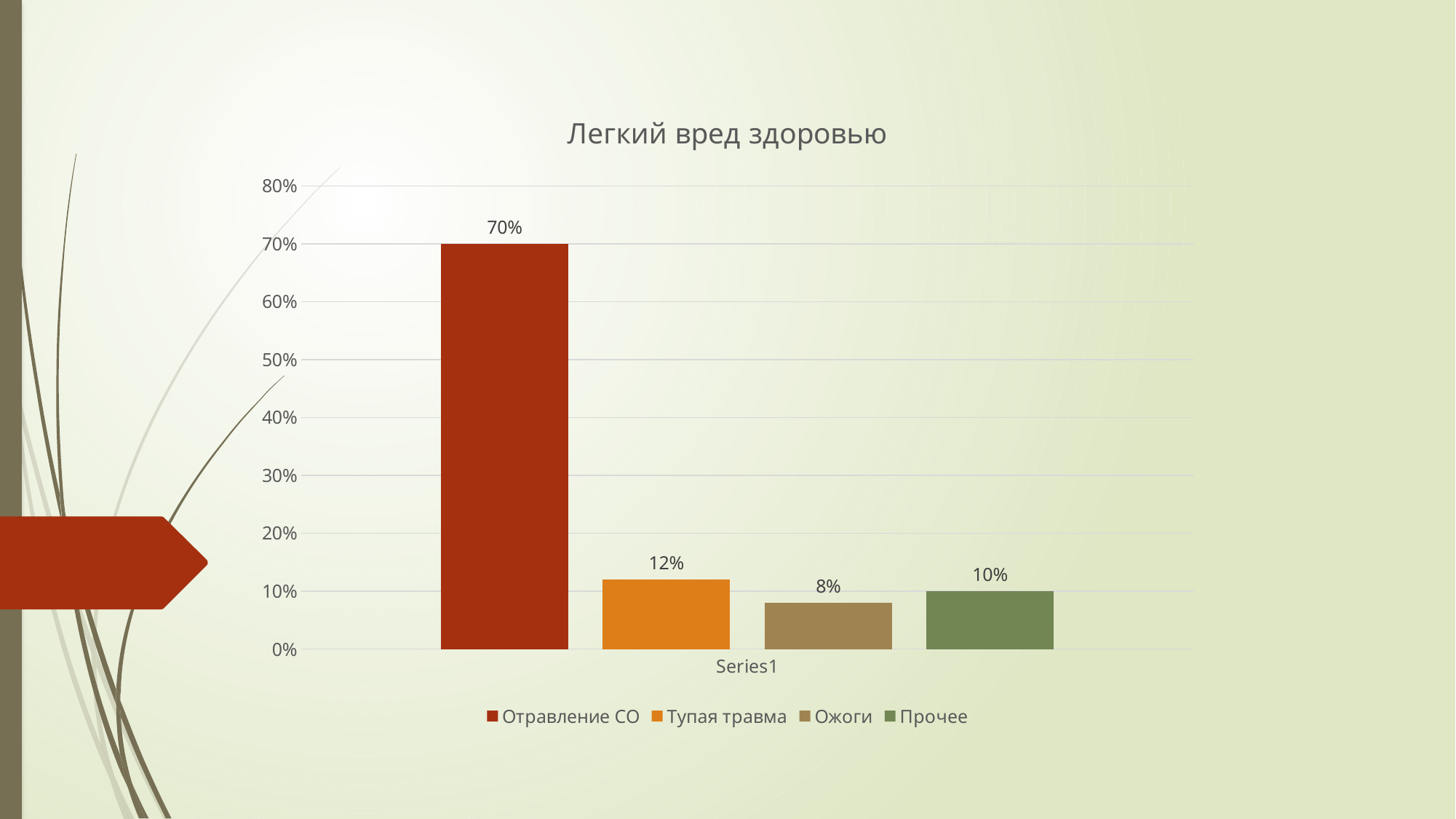
What is the title of the chart? Легкий вред здоровью What is the value for Ожоги? 8% What is the value for Прочее? 10% What is the difference between the values for Отравление СО and Тупая травма? 58% What is the value for Отравление СО? 70% Which is larger, the value for Прочее or the value for Ожоги? Прочее How many series does the legend list? 4 Which category has the lowest value? Ожоги Is the value for Отравление СО greater or less than 60%? greater What is the value for Тупая травма? 12% Which category has the highest value? Отравление СО What kind of chart is shown on the slide? bar chart